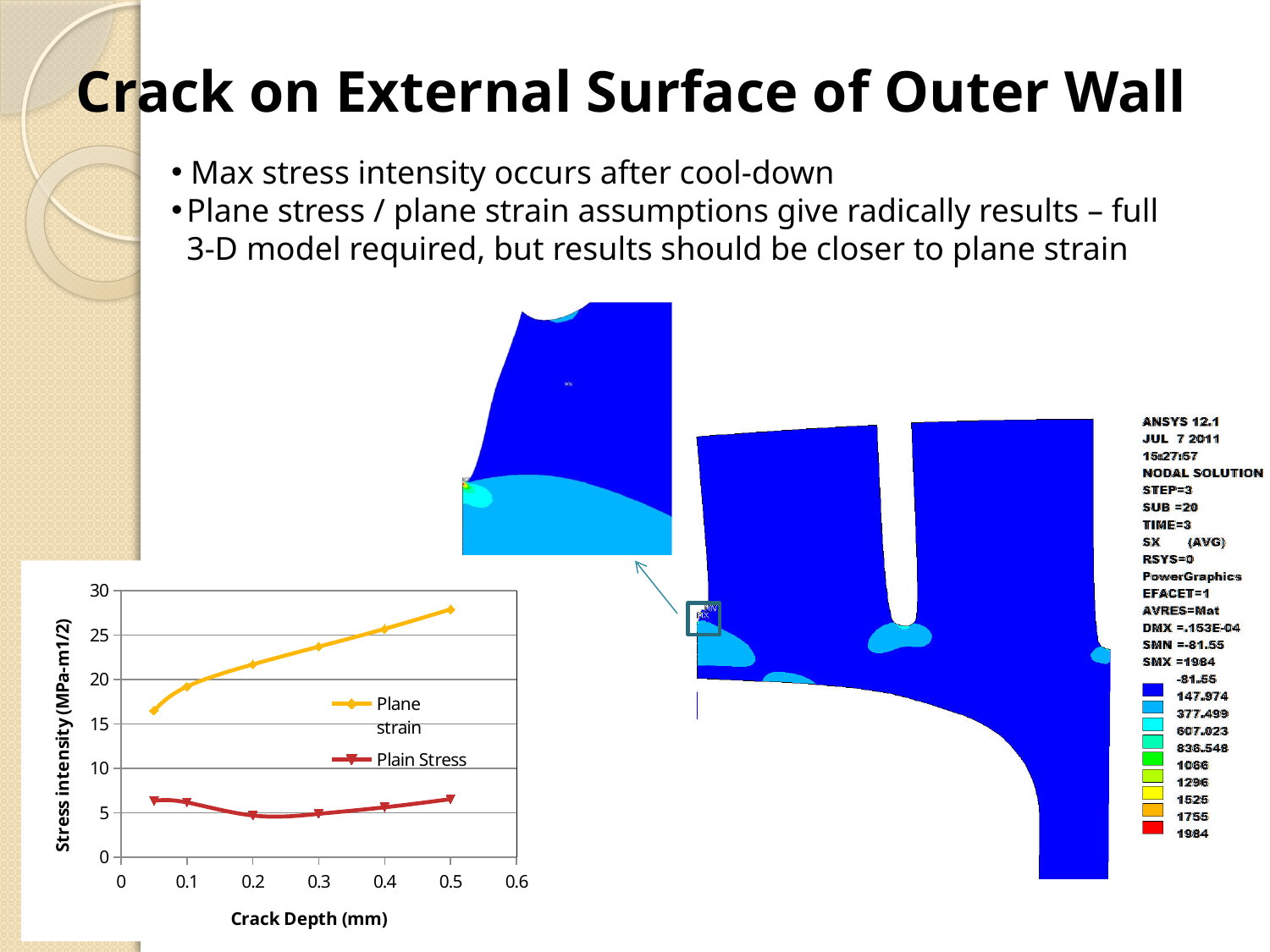
How many data points are plotted for the Plane strain series? 6 At which crack depth is the Plane strain stress intensity highest? 0.5 Is the Plane strain value at a crack depth of 0.3 mm greater or less than 25? less What kind of chart is shown on the slide? line chart What are the two series named in the chart legend? Plane strain and Plain Stress Does the Plane strain series rise or fall as crack depth increases? rises Is the Plane strain value at a crack depth of 0.5 mm greater or less than 25? greater What is the title of the chart's x axis? Crack Depth (mm) Is the Plain Stress value at a crack depth of 0.5 mm greater or less than 10? less How many series does the chart legend list? 2 At a crack depth of 0.5 mm, which series has the larger stress intensity, Plane strain or Plain Stress? Plane strain